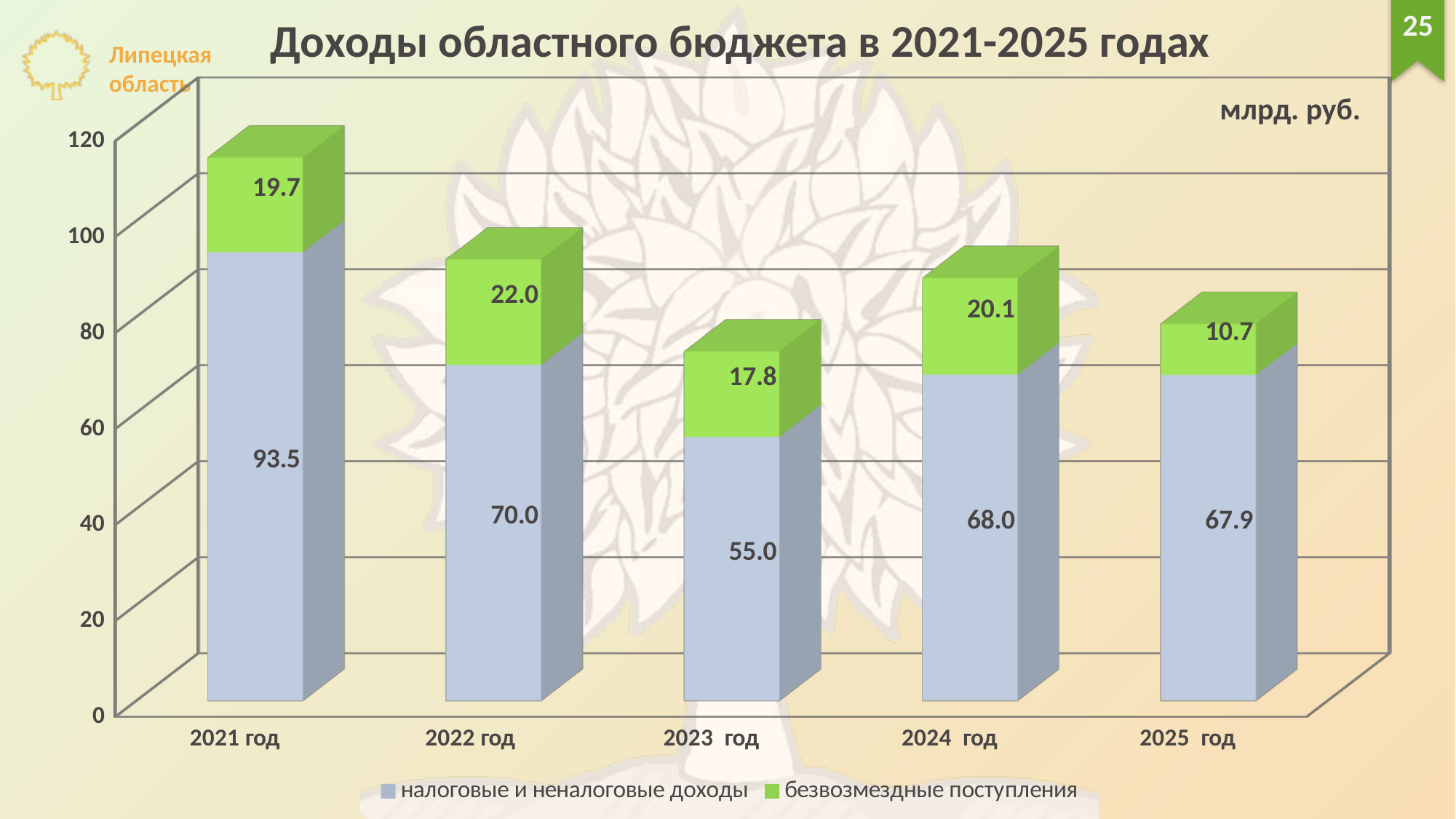
Which year has the lowest value of безвозмездные поступления? 2025 год What unit of measurement is indicated on the chart? млрд. руб. What is the value of безвозмездные поступления for 2022 год? 22.0 What is the total of the stacked bar for 2021 год? 113.2 What is the difference between налоговые и неналоговые доходы in 2021 год and 2022 год? 23.5 Which is larger: безвозмездные поступления in 2023 год or in 2024 год? 2024 год What is the value of налоговые и неналоговые доходы for 2021 год? 93.5 What is the value of безвозмездные поступления for 2025 год? 10.7 Which year has the highest value of налоговые и неналоговые доходы? 2021 год How many years are shown on the x axis? 5 What is the total of the stacked bar for 2023 год? 72.8 How many series does the legend list? 2